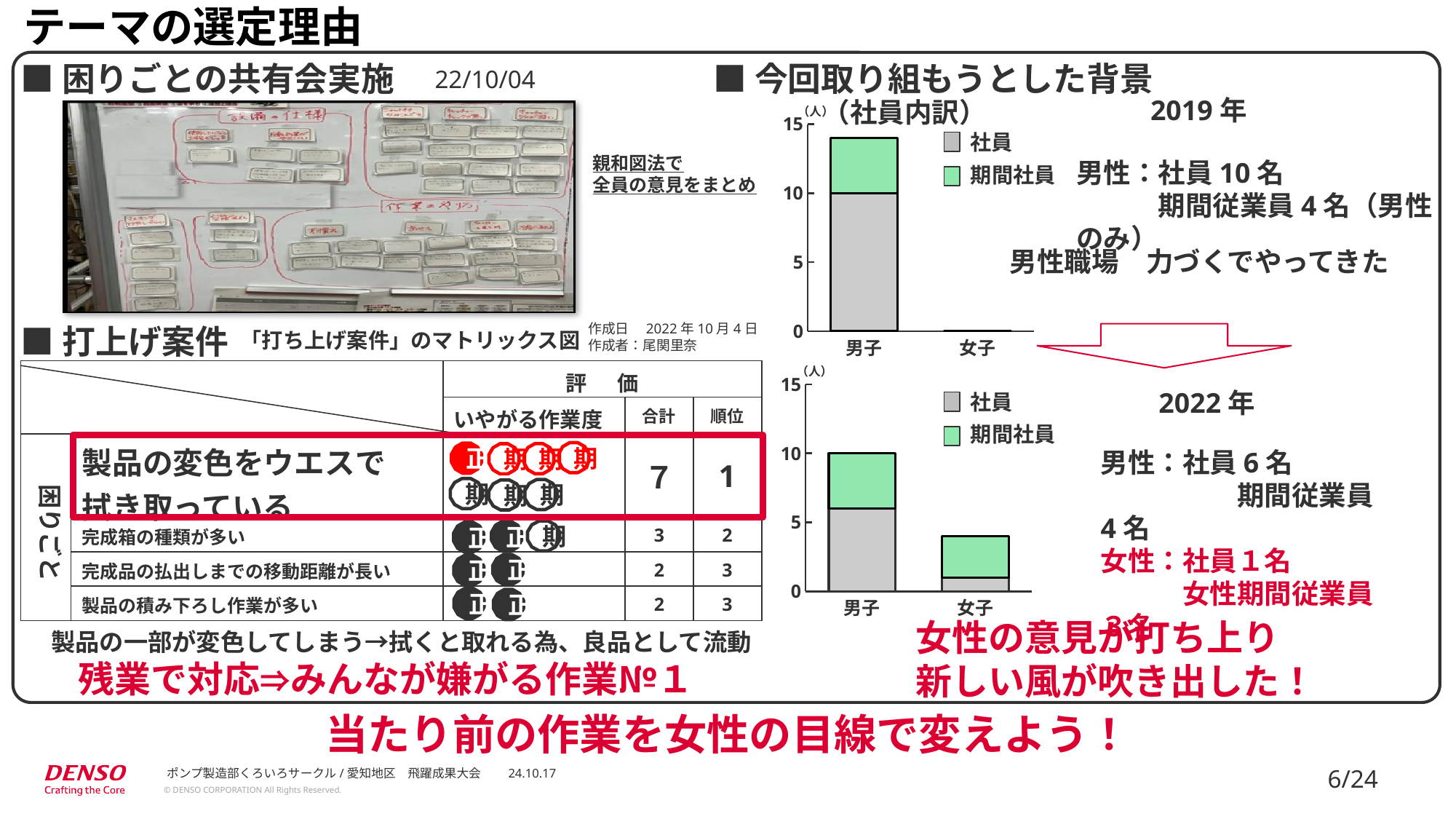
In the 2022年 chart, what is the total of the 男子 stacked bar? 10 How many categories are shown on the x axis of the 2022年 chart? 2 In the 2019年 chart, what is the 社員 value for 男子 (as stated on the slide)? 10 What kind of chart is the top chart (2019年, 社員内訳)? stacked bar chart In the 2022年 chart, is the 社員 portion of the 男子 bar greater or less than 5? greater How many series does the legend of the 2019年 chart list? 2 In the 2019年 chart, which category has the taller bar, 男子 or 女子? 男子 In the 2022年 chart, which category has the lower total bar? 女子 What unit is shown on the y axis of both charts? (人) In the 2019年 chart, is the total bar for 男子 greater or less than 10? greater In the 2022年 chart, is the total bar for 女子 greater or less than 5? less What are the two legend entries in the 2022年 chart? 社員, 期間社員